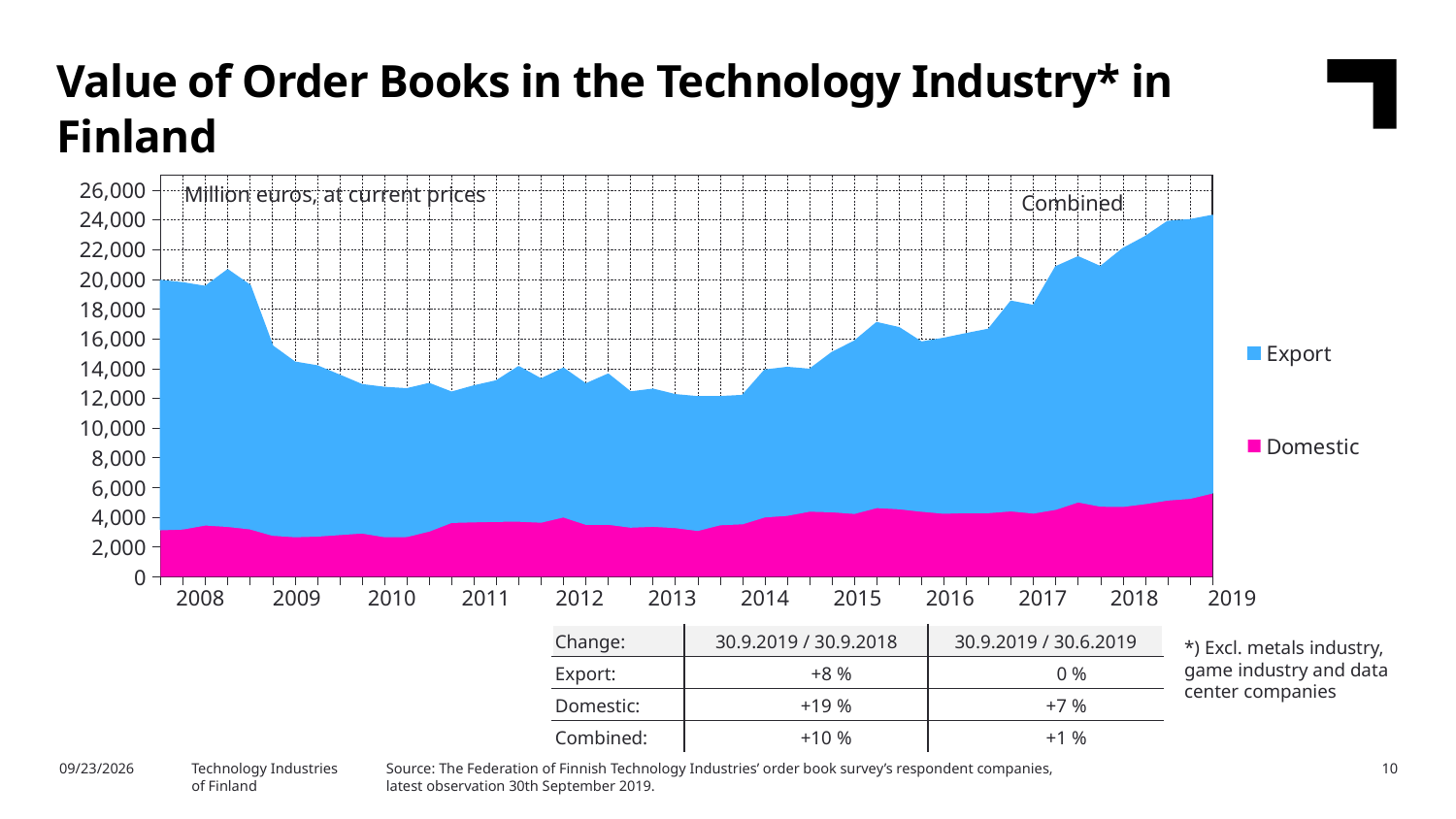
What kind of chart is shown on the slide? Area chart How many years are labelled on the x axis? 12 What are the two series named in the legend? Export and Domestic How many series does the legend list? 2 Is the Domestic value in 2010 greater or less than 4,000? less Does the combined value rise or fall between 2013 and 2019? rise Which is larger, the combined value in 2013 or the combined value in 2019? 2019 In which year does the combined value reach its highest level? 2019 Is the combined value in 2013 greater or less than 14,000? less Is the combined value at the end of the series in 2019 greater or less than 22,000? greater In what unit are the values on the chart expressed, according to the label inside the plot area? Million euros, at current prices